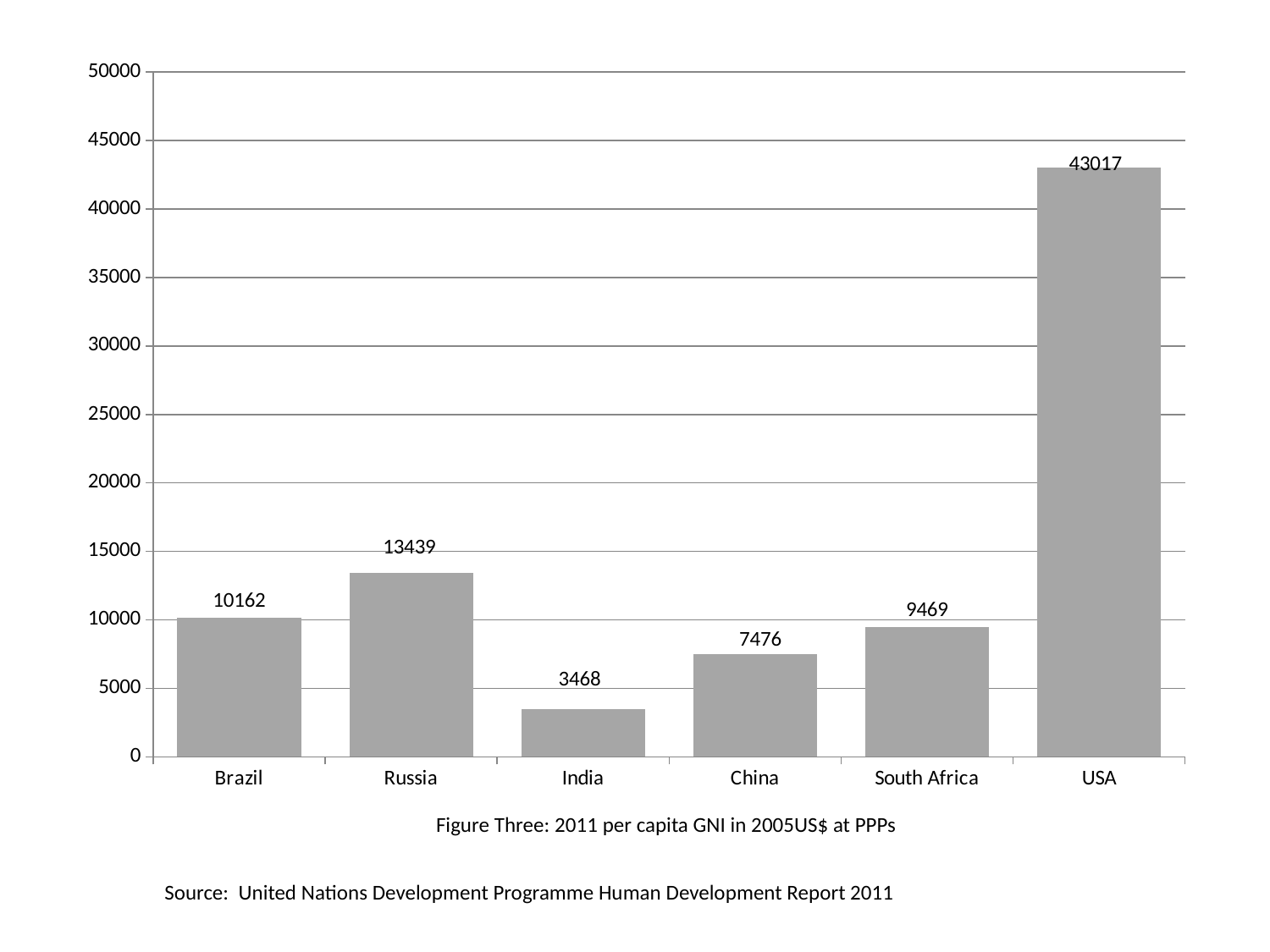
What kind of chart is shown on the slide? Bar chart What is the value shown for India? 3468 What is the difference between the values for USA and China? 35541 Which has a larger value, China or South Africa? South Africa How many countries are shown in the chart? 6 Which country has the highest per capita GNI in the chart? USA What is the value shown for South Africa? 9469 What is the difference between the values for Russia and Brazil? 3277 Which country has the lowest per capita GNI in the chart? India What is the title of the chart? Figure Three: 2011 per capita GNI in 2005US$ at PPPs What is the value shown for Russia? 13439 What is the 2011 per capita GNI value shown for Brazil? 10162